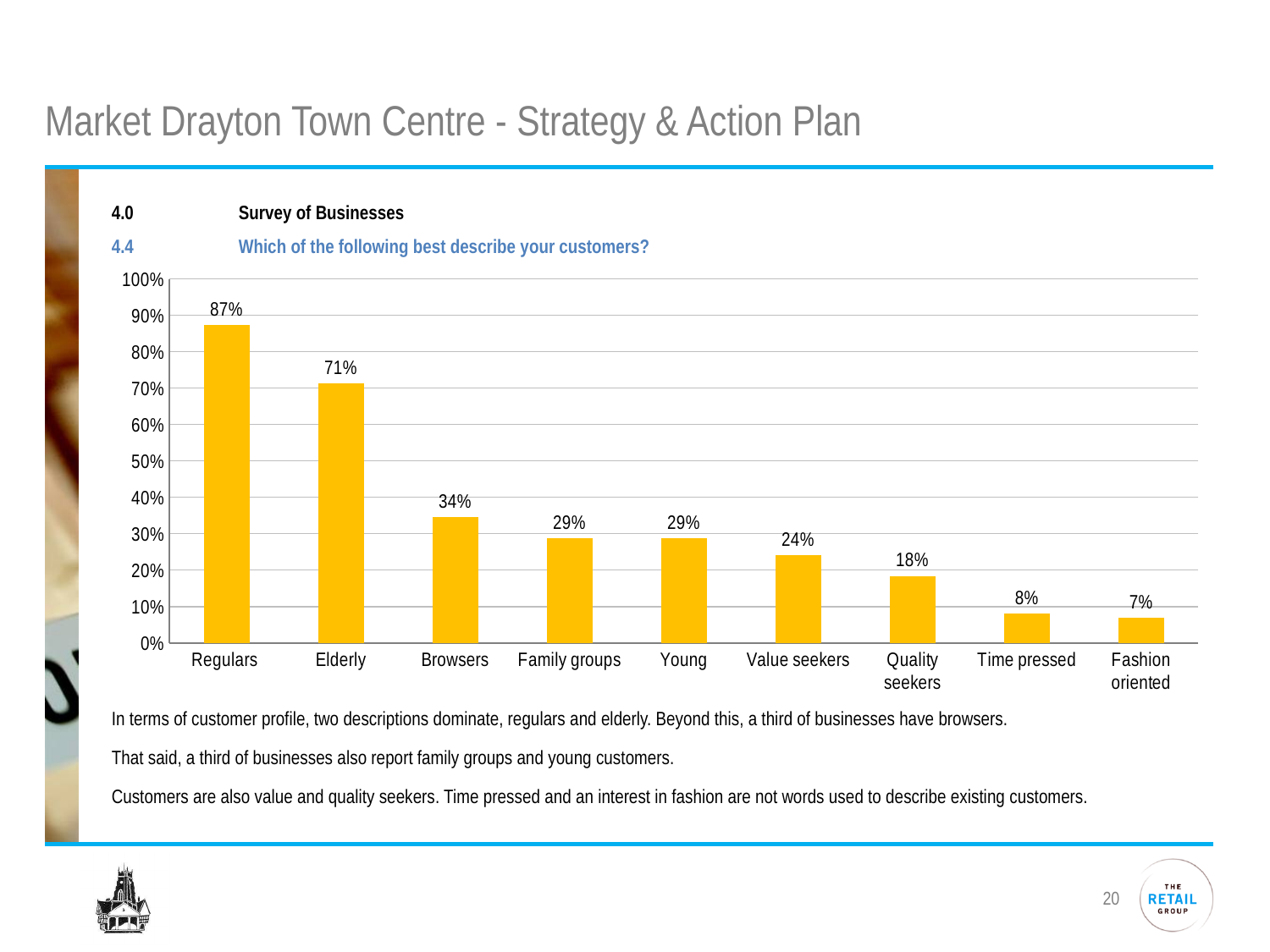
Which customer description has the lowest value? Fashion oriented What is the difference between the values for Regulars and Elderly? 16% What percentage is shown for Value seekers? 24% Do the values rise or fall moving from left to right along the x axis? Fall What kind of chart is shown on the slide? Bar chart What is the value shown for Elderly? 71% Is the value for Time pressed greater or less than 10%? less How many customer descriptions are shown on the x axis? 9 Which customer description has the highest value? Regulars What percentage of businesses describe their customers as Regulars? 87% What is the difference between the values for Browsers and Quality seekers? 16% Which is larger, the value for Browsers or the value for Value seekers? Browsers